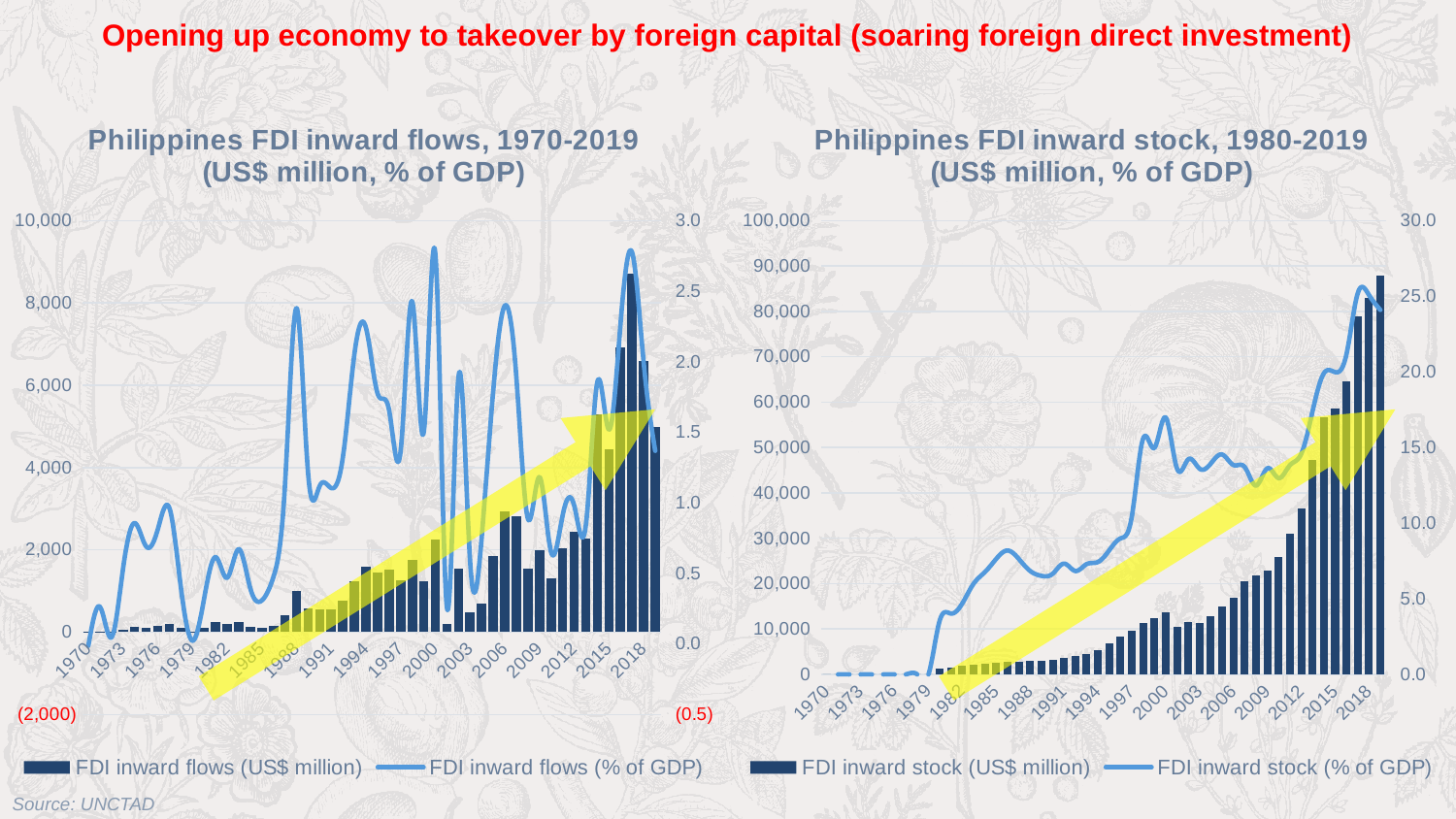
In the 'Philippines FDI inward flows, 1970-2019' chart, which series is shown as bars? FDI inward flows (US$ million) How many series does the legend list for the 'Philippines FDI inward flows, 1970-2019' chart? 2 How many series does the legend list for the 'Philippines FDI inward stock, 1980-2019' chart? 2 What kind of chart is the 'Philippines FDI inward flows, 1970-2019' chart on the left? A combined bar and line chart What is the title of the chart on the right of the slide? Philippines FDI inward stock, 1980-2019 (US$ million, % of GDP) In the 'Philippines FDI inward stock, 1980-2019' chart, is the FDI inward stock (US$ million) bar for 2000 greater or less than 20,000? less In the 'Philippines FDI inward flows, 1970-2019' chart, is the FDI inward flows (% of GDP) line value for 2000 greater or less than 2.0? greater In the 'Philippines FDI inward stock, 1980-2019' chart, is the FDI inward stock (US$ million) bar for 2019 greater or less than 80,000? greater In the 'Philippines FDI inward stock, 1980-2019' chart, do the FDI inward stock (US$ million) bars generally rise or fall from 1980 to 2019? rise In the 'Philippines FDI inward stock, 1980-2019' chart, which year has the tallest FDI inward stock (US$ million) bar? 2019